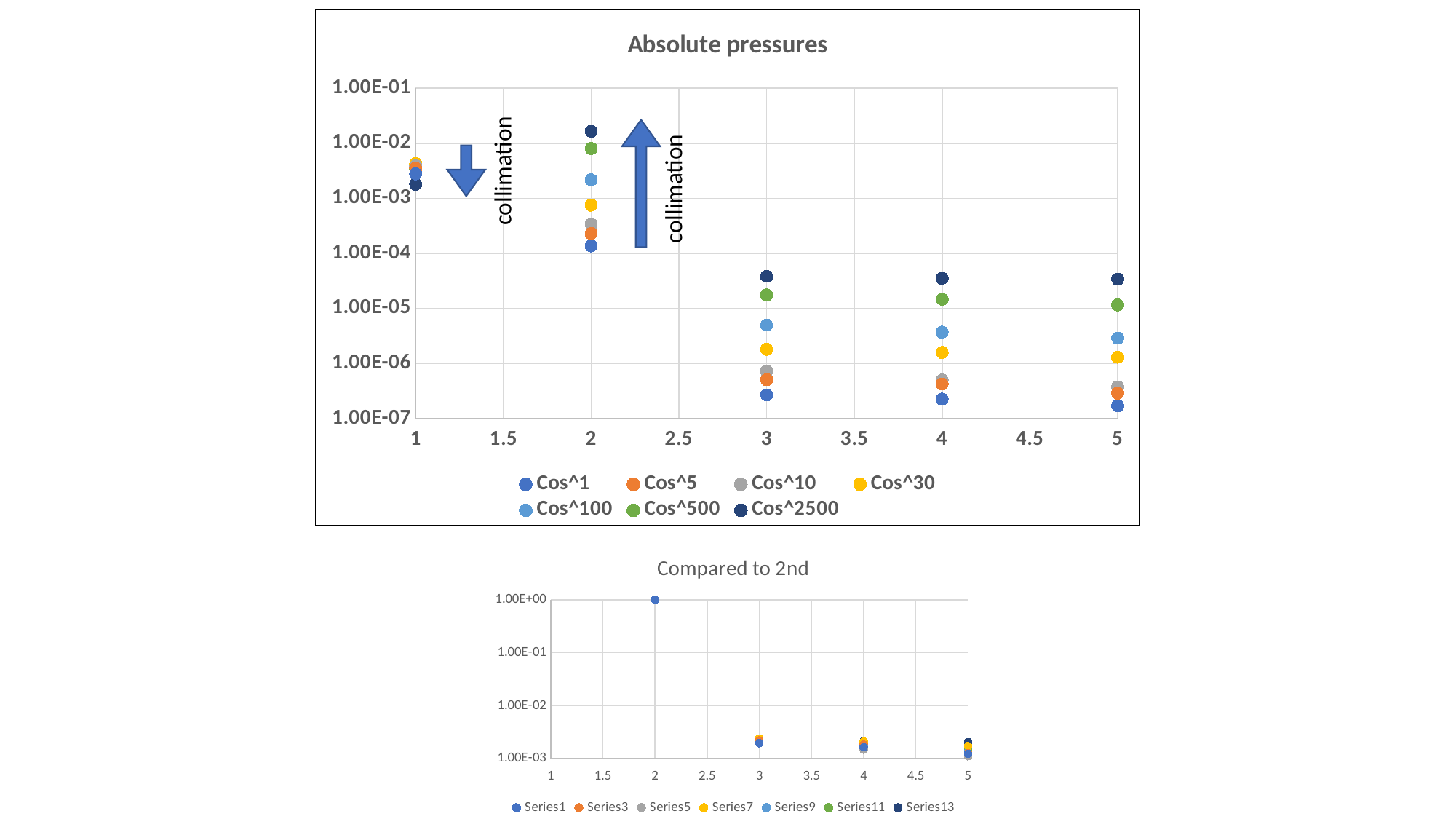
In the 'Absolute pressures' chart, at x = 2, which is larger: Cos^500 or Cos^100? Cos^500 What kind of chart is the 'Absolute pressures' chart? Scatter chart In the 'Compared to 2nd' chart, how many series does the legend list? 7 In the 'Absolute pressures' chart, is the value of Cos^2500 at x = 2 greater or less than 1.00E-02? greater In the 'Absolute pressures' chart, is the value of Cos^500 at x = 3 greater or less than 1.00E-05? greater In the 'Absolute pressures' chart, which series has the highest value at x = 2? Cos^2500 In the 'Absolute pressures' chart, do the values of Cos^2500 rise or fall from x = 2 to x = 5? fall In the 'Absolute pressures' chart, how many series does the legend list? 7 In the 'Absolute pressures' chart, is the value of Cos^1 at x = 2 greater or less than 1.00E-03? less In the 'Absolute pressures' chart, which series has the lowest value at x = 2? Cos^1 In the 'Compared to 2nd' chart, what is the value of the point plotted at x = 2? 1.00E+00 In the 'Absolute pressures' chart, what word labels the two blue arrows? collimation